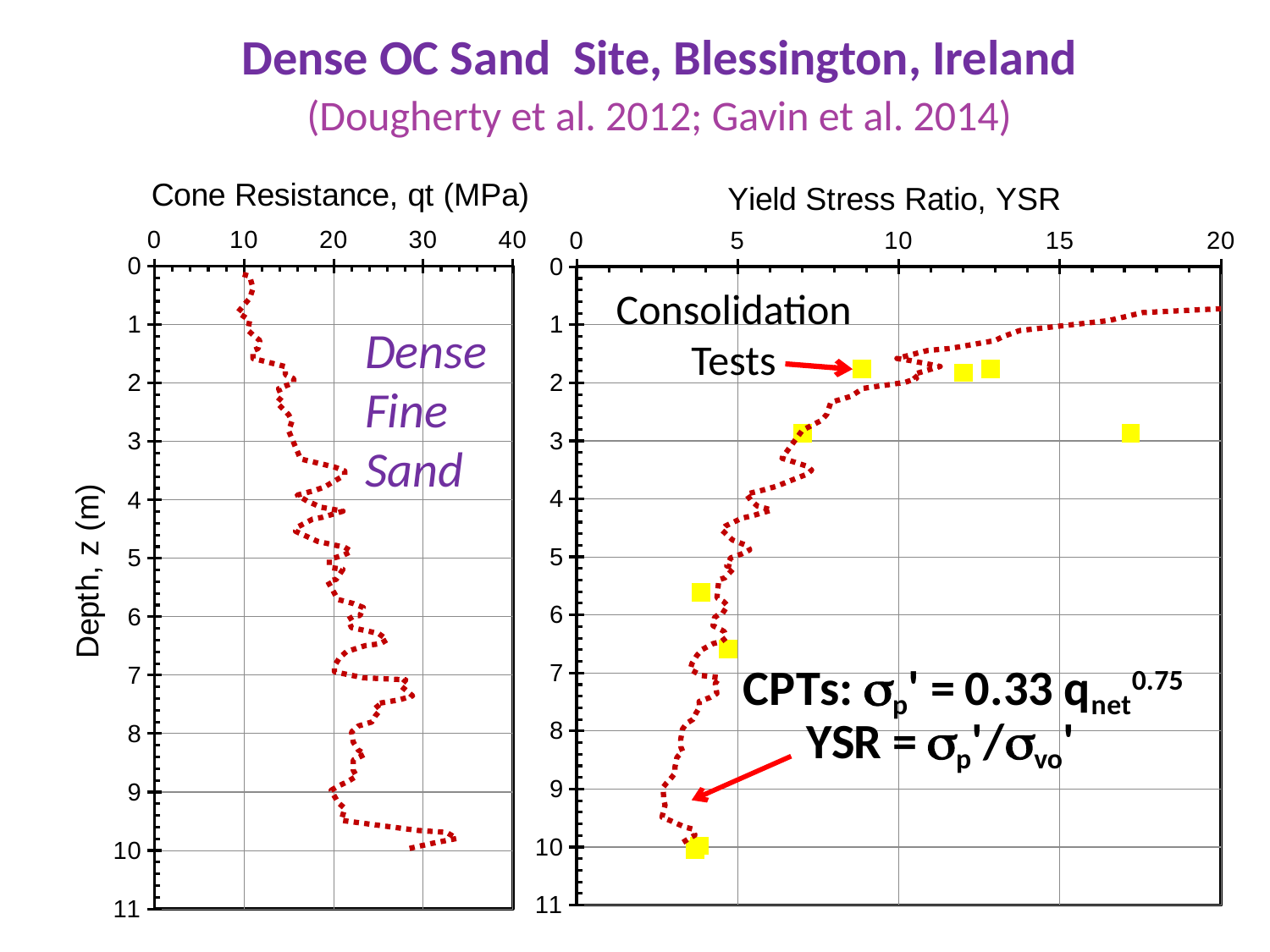
On the right chart, Yield Stress Ratio, YSR, is the YSR from the CPT profile at a depth of 1 m greater or less than 15? greater On the right chart, Yield Stress Ratio, YSR, does the YSR profile generally rise or fall as depth increases from 1 m to 9 m? fall On the right chart, Yield Stress Ratio, YSR, how many yellow square consolidation test points are plotted? 8 What kind of chart is the left chart, Cone Resistance, qt (MPa)? line chart On the left chart, Cone Resistance, qt (MPa), does cone resistance generally increase or decrease as depth increases from 0 to 10 m? increase What is the title of the horizontal axis on the right chart? Yield Stress Ratio, YSR On the left chart, Cone Resistance, qt (MPa), is the cone resistance larger at a depth of 10 m or at a depth of 1 m? 10 m On the right chart, Yield Stress Ratio, YSR, is the YSR from the CPT profile at a depth of 9 m greater or less than 5? less On the left chart, Cone Resistance, qt (MPa), is the cone resistance at a depth of 1 m greater or less than 20 MPa? less On the left chart, Cone Resistance, qt (MPa), what is the maximum value shown on the horizontal axis? 40 On the right chart, Yield Stress Ratio, YSR, is the YSR larger at a depth of 1 m or at a depth of 9 m? 1 m